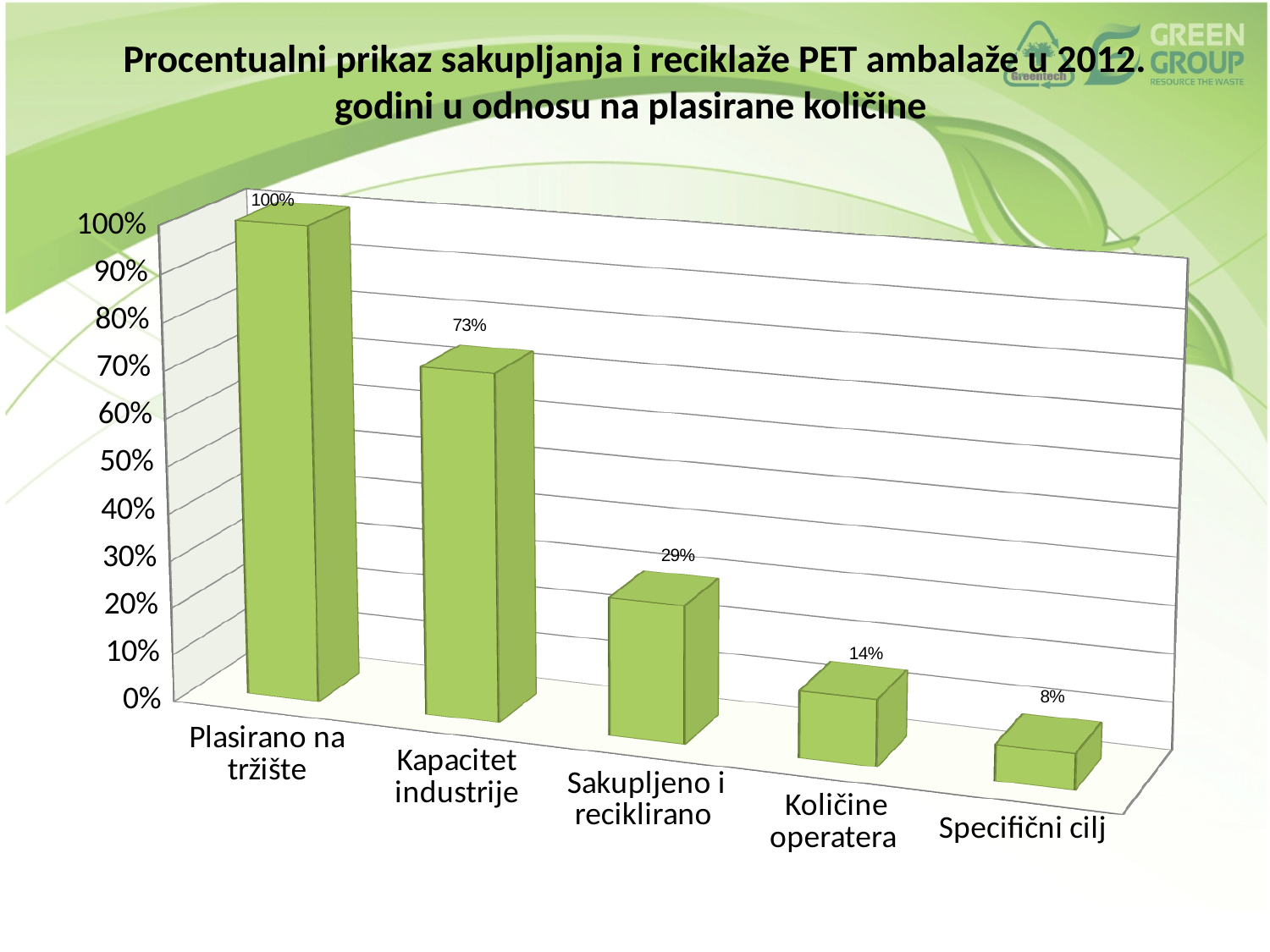
Do the values rise or fall from left to right along the x axis? fall Which category has the lowest value? Specifični cilj What is the value for Sakupljeno i reciklirano? 29% How many categories are shown on the chart? 5 Which is larger, the value for Količine operatera or the value for Specifični cilj? Količine operatera What is the value for Količine operatera? 14% What kind of chart is shown on the slide? bar chart What is the value for Kapacitet industrije? 73% What is the value for Specifični cilj? 8% Is the value for Kapacitet industrije greater or less than 50%? greater Which category has the highest value? Plasirano na tržište What is the difference between the values for Kapacitet industrije and Sakupljeno i reciklirano? 44%